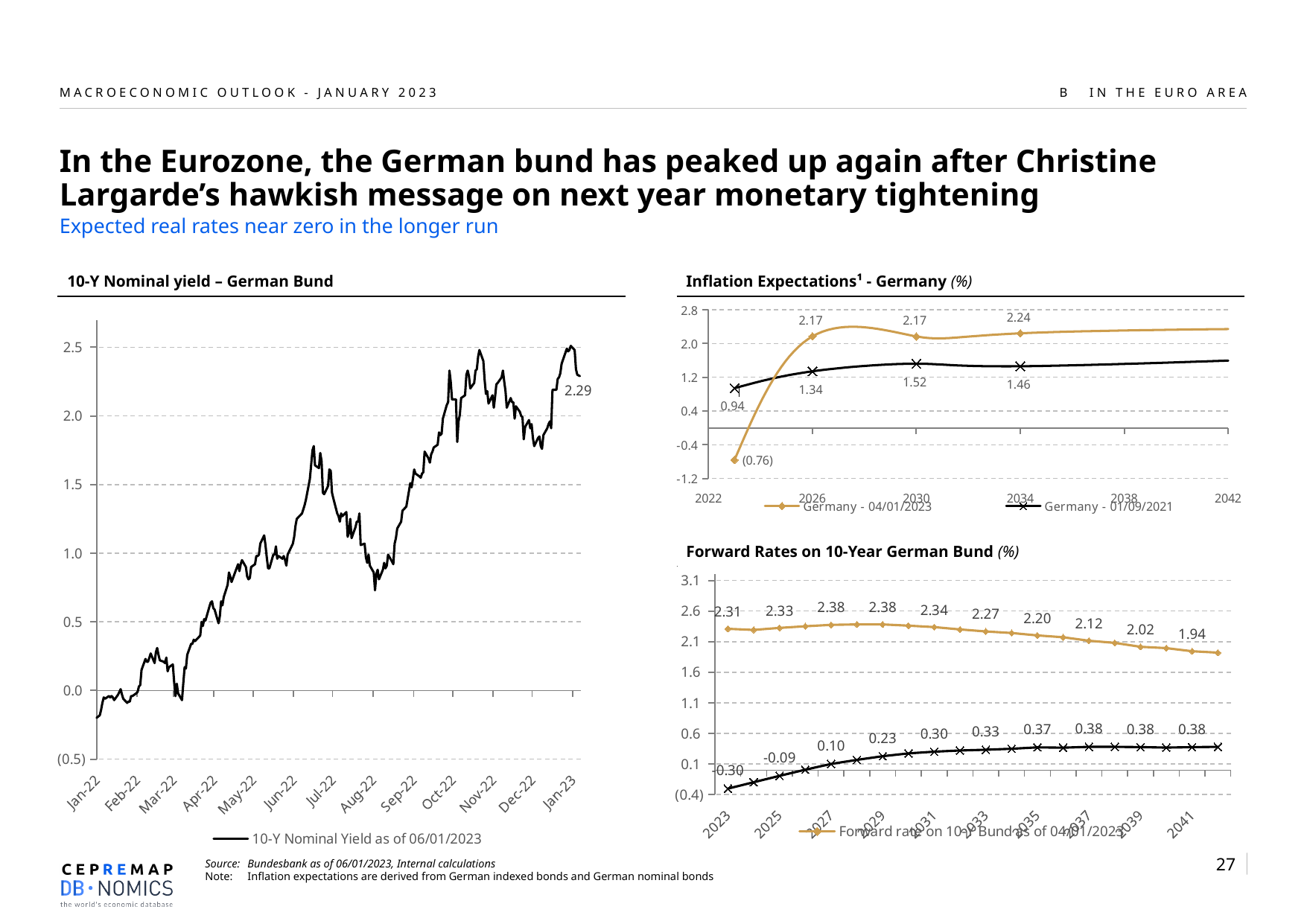
In the 'Forward Rates on 10-Year German Bund' chart, what is the last labeled value on the upper (gold) line? 1.94 In the '10-Y Nominal yield – German Bund' chart, is the value at Jan-22 greater or less than 0.5? less In the 'Forward Rates on 10-Year German Bund' chart, what is the highest labeled value on the upper (gold) line? 2.38 In the 'Inflation Expectations - Germany' chart, what is the first labeled value of the 'Germany - 01/09/2021' series? 0.94 In the 'Inflation Expectations - Germany' chart, what is the first labeled value of the 'Germany - 04/01/2023' series? (0.76) In the 'Forward Rates on 10-Year German Bund' chart, what is the lowest labeled value on the lower (black) line? -0.30 In the 'Inflation Expectations - Germany' chart, what is the difference between the last labeled values of the two series, 2.24 and 1.46? 0.78 In the 'Inflation Expectations - Germany' chart, at the second labeled point, which series is higher: 'Germany - 04/01/2023' (2.17) or 'Germany - 01/09/2021' (1.34)? Germany - 04/01/2023 How many series does the legend of the 'Inflation Expectations - Germany' chart list? 2 In the '10-Y Nominal yield – German Bund' chart, does the yield overall rise or fall from Jan-22 to Jan-23? rise In the '10-Y Nominal yield – German Bund' chart, what is the latest value labeled at the end of the line? 2.29 What kind of chart is the '10-Y Nominal yield – German Bund' chart? line chart